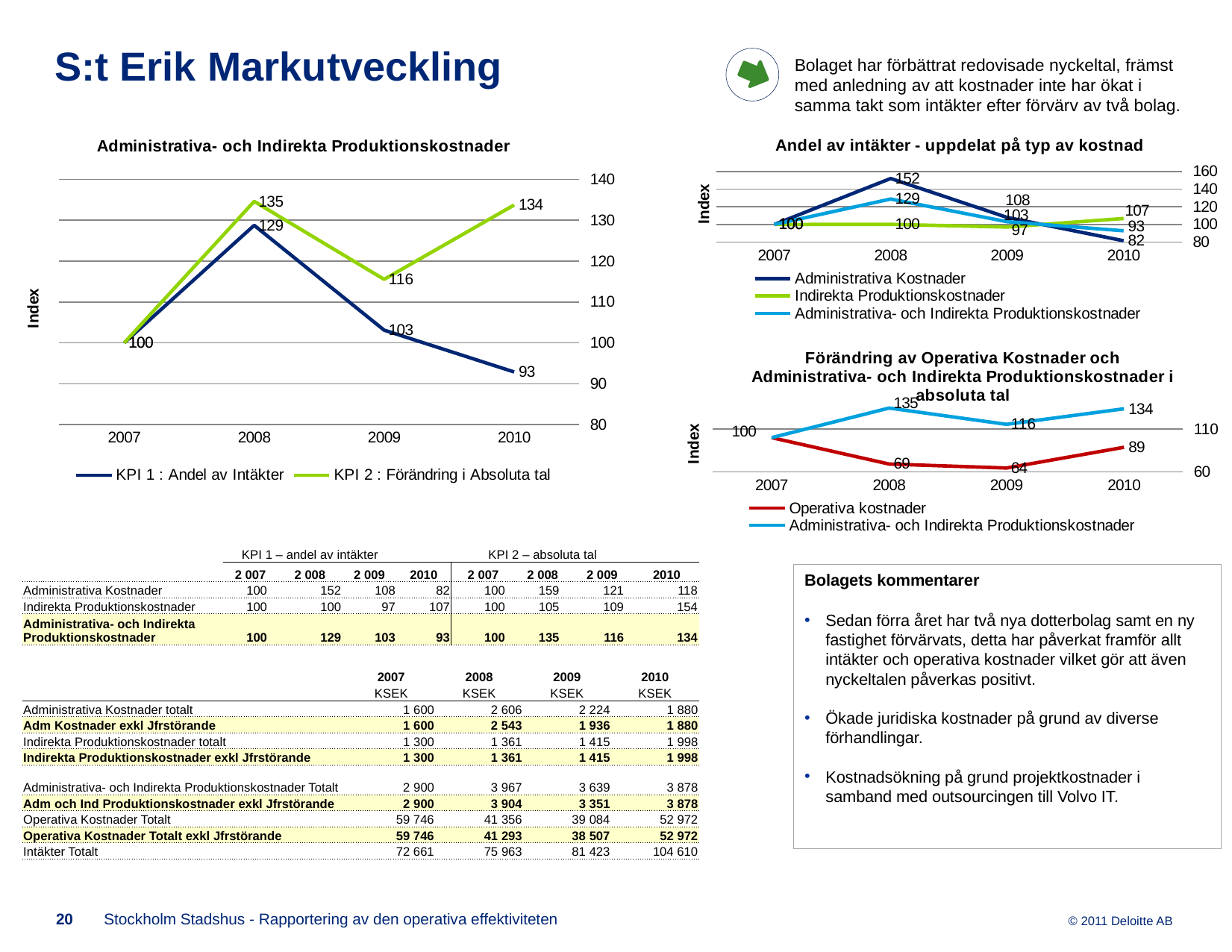
In the chart titled 'Andel av intäkter - uppdelat på typ av kostnad', what is the value of Indirekta Produktionskostnader in 2009? 97 In the chart titled 'Administrativa- och Indirekta Produktionskostnader', does KPI 1 : Andel av Intäkter rise or fall from 2008 to 2010? fall In the chart titled 'Administrativa- och Indirekta Produktionskostnader', what is the difference between KPI 2 and KPI 1 in 2010? 41 In the chart titled 'Andel av intäkter - uppdelat på typ av kostnad', how many series does the legend list? 3 In the chart titled 'Andel av intäkter - uppdelat på typ av kostnad', what is the value of Administrativa Kostnader in 2008? 152 In the chart titled 'Administrativa- och Indirekta Produktionskostnader', what is the value of KPI 1 : Andel av Intäkter in 2010? 93 In the chart titled 'Administrativa- och Indirekta Produktionskostnader', in which year does KPI 2 : Förändring i Absoluta tal reach its highest value? 2008 In the chart titled 'Administrativa- och Indirekta Produktionskostnader', what is the value of KPI 2 : Förändring i Absoluta tal in 2009? 116 In the chart titled 'Andel av intäkter - uppdelat på typ av kostnad', which series has the lowest value in 2010? Administrativa Kostnader In the bottom-right chart ('Förändring av Operativa Kostnader ...'), what is the value of Operativa kostnader in 2009? 64 What type of chart is the chart titled 'Administrativa- och Indirekta Produktionskostnader'? line chart In the bottom-right chart ('Förändring av Operativa Kostnader ...'), which series is higher in 2010, Operativa kostnader or Administrativa- och Indirekta Produktionskostnader? Administrativa- och Indirekta Produktionskostnader